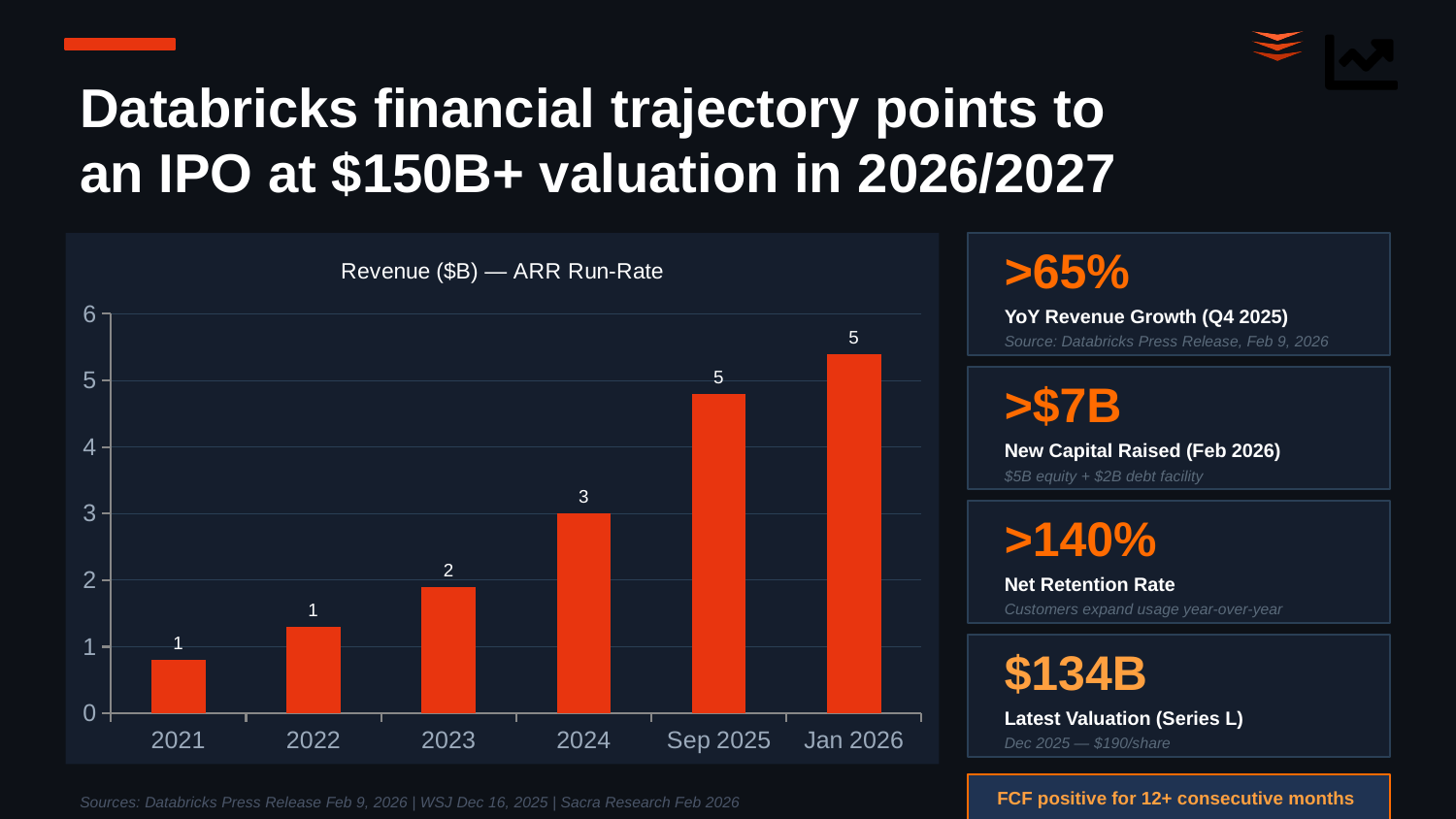
What is the data label on the bar for Jan 2026 in the Revenue ($B) — ARR Run-Rate chart? 5 What is the data label on the bar for 2024 in the Revenue ($B) — ARR Run-Rate chart? 3 Which category has the lowest bar in the Revenue ($B) — ARR Run-Rate chart? 2021 Do the values in the Revenue ($B) — ARR Run-Rate chart rise or fall from 2021 to Jan 2026? Rise What type of chart is used to show Revenue ($B) — ARR Run-Rate? Bar chart What is the data label on the bar for 2023 in the Revenue ($B) — ARR Run-Rate chart? 2 Which category has the highest bar in the Revenue ($B) — ARR Run-Rate chart? Jan 2026 How many bars are shown in the Revenue ($B) — ARR Run-Rate chart? 6 In the Revenue ($B) — ARR Run-Rate chart, which bar is taller: 2021 or 2022? 2022